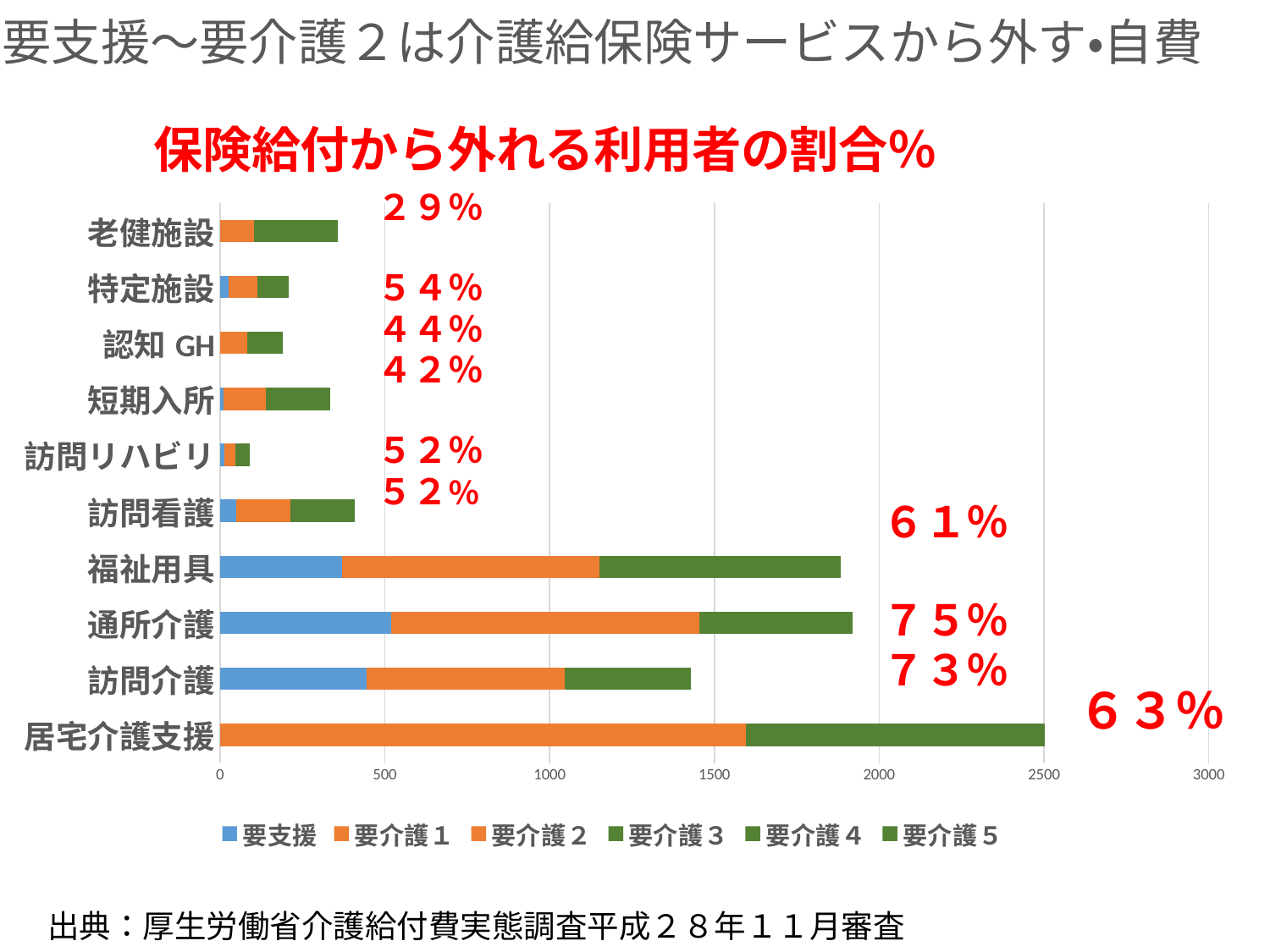
Which has the longer total bar, 通所介護 or 訪問介護? 通所介護 How many categories are plotted on the chart? 10 Is the total bar length for 居宅介護支援 greater or less than 2000? greater Is the total bar length for 老健施設 greater or less than 500? less Is the total bar length for 訪問介護 greater or less than 1500? less Which category has the longest total bar? 居宅介護支援 Which category has the shortest total bar? 訪問リハビリ What percentage is written next to the 通所介護 bar? 75% What is the title of the chart? 保険給付から外れる利用者の割合% Which has the longer total bar, 福祉用具 or 訪問看護? 福祉用具 What kind of chart is shown on the slide? bar chart How many series does the legend list? 6